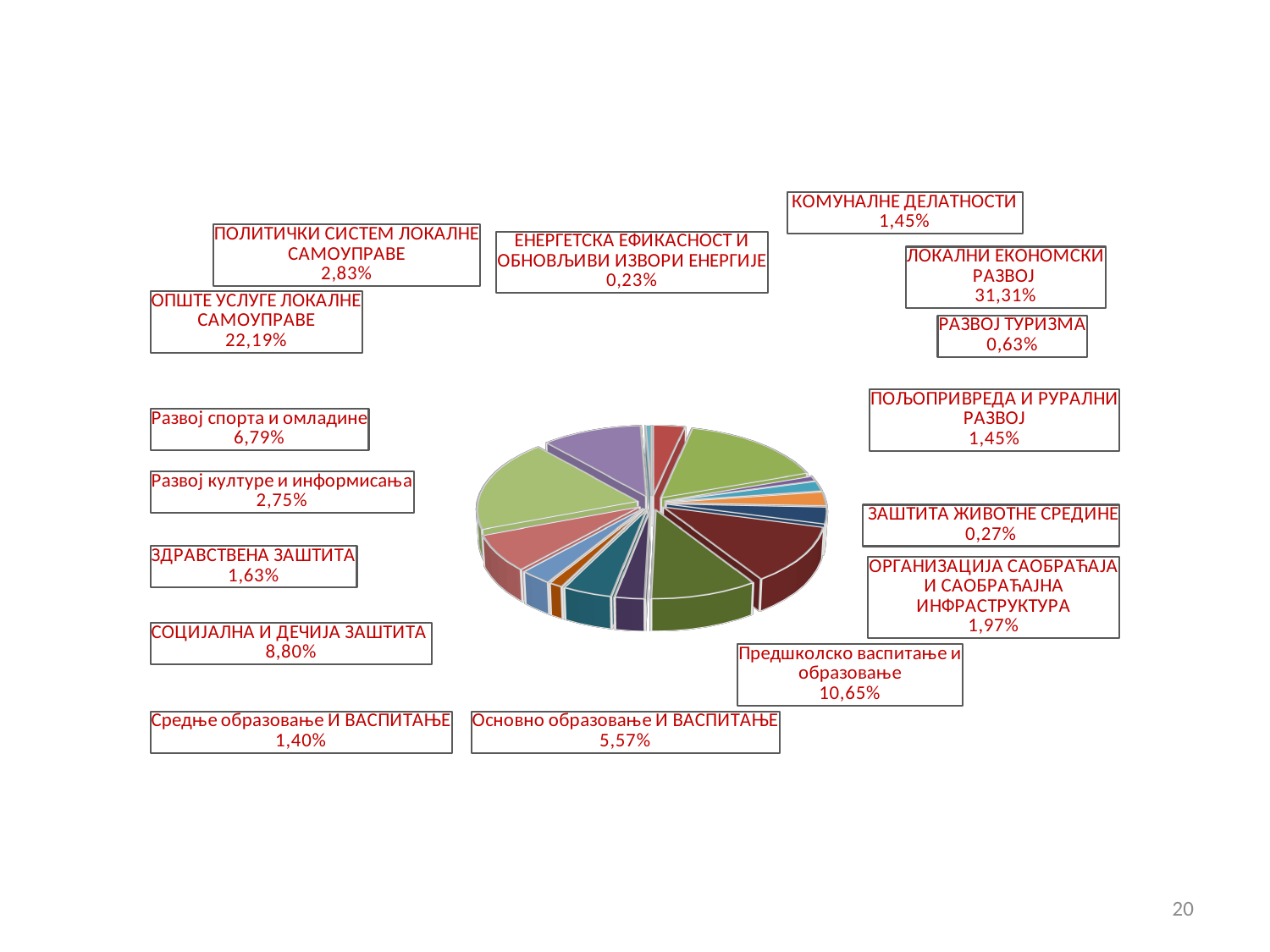
What is the value shown for Предшколско васпитање и образовање? 10,65% Which category has the smallest share of the pie? ЕНЕРГЕТСКА ЕФИКАСНОСТ И ОБНОВЉИВИ ИЗВОРИ ЕНЕРГИЈЕ What is the difference between the shares of ЛОКАЛНИ ЕКОНОМСКИ РАЗВОЈ and ОПШТЕ УСЛУГЕ ЛОКАЛНЕ САМОУПРАВЕ? 9,12% What is the difference between the shares of Предшколско васпитање и образовање and СОЦИЈАЛНА И ДЕЧИЈА ЗАШТИТА? 1,85% What is the value shown for ОПШТЕ УСЛУГЕ ЛОКАЛНЕ САМОУПРАВЕ? 22,19% Which category has the largest share of the pie? ЛОКАЛНИ ЕКОНОМСКИ РАЗВОЈ What is the value shown for РАЗВОЈ ТУРИЗМА? 0,63% What share of the pie does ЛОКАЛНИ ЕКОНОМСКИ РАЗВОЈ represent? 31,31% What is the value shown for СОЦИЈАЛНА И ДЕЧИЈА ЗАШТИТА? 8,80% How many categories are shown in the pie chart? 16 What kind of chart is shown on the slide? Pie chart Which has the larger share: Развој спорта и омладине or Основно образовање И ВАСПИТАЊЕ? Развој спорта и омладине